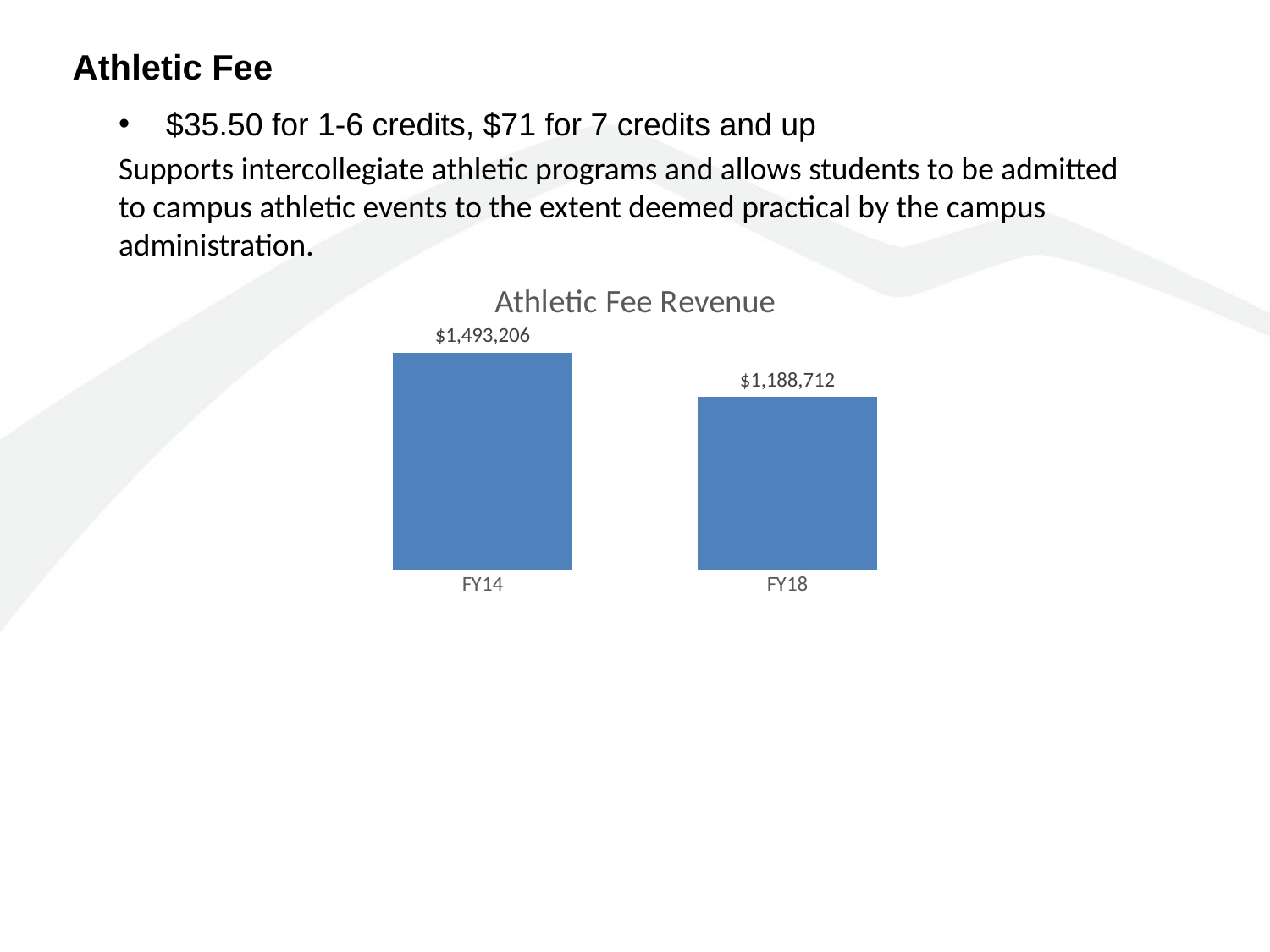
What is the Athletic Fee Revenue for FY18? $1,188,712 How many fiscal years are shown in the Athletic Fee Revenue chart? 2 Is the Athletic Fee Revenue larger in FY14 or FY18? FY14 Which fiscal year has the higher Athletic Fee Revenue? FY14 What kind of chart is used to show Athletic Fee Revenue? Bar chart What is the difference in Athletic Fee Revenue between FY14 and FY18? $304,494 What is the Athletic Fee Revenue for FY14? $1,493,206 What is the title of the chart on the slide? Athletic Fee Revenue What colour are the bars in the Athletic Fee Revenue chart? Blue Does Athletic Fee Revenue rise or fall from FY14 to FY18? Fall Which fiscal year has the lower Athletic Fee Revenue? FY18